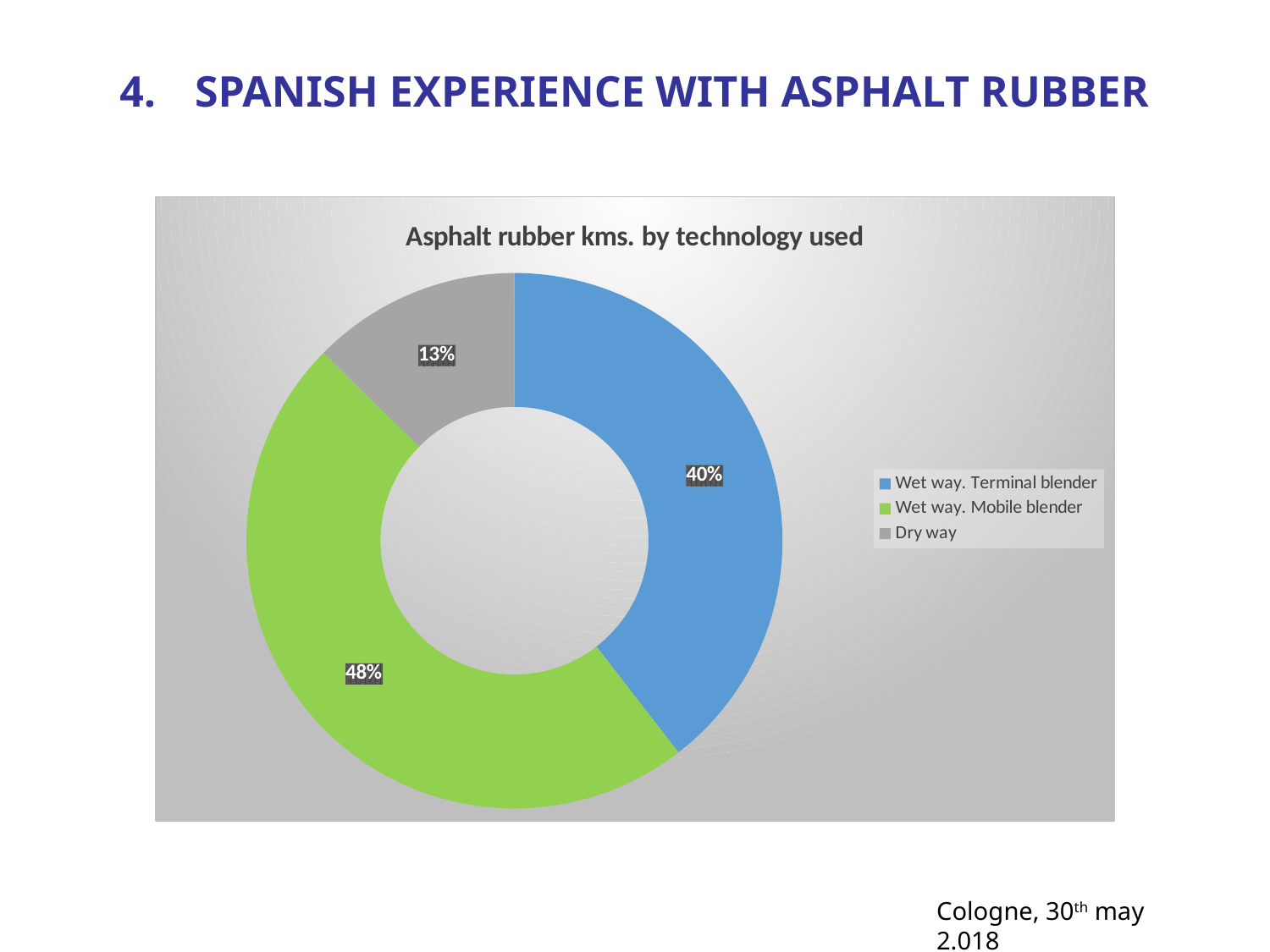
What is the title of the chart? Asphalt rubber kms. by technology used Which colour represents Dry way in the chart? Grey What is the difference in percentage points between the Wet way. Terminal blender share and the Dry way share? 27 Which technology has the largest share of asphalt rubber kms? Wet way. Mobile blender Which technology has the smallest share of asphalt rubber kms? Dry way Which has a larger share, Wet way. Terminal blender or Dry way? Wet way. Terminal blender What share of asphalt rubber kms is attributed to Wet way. Mobile blender? 48% What is the difference in percentage points between the Wet way. Mobile blender share and the Wet way. Terminal blender share? 8 What share of asphalt rubber kms is attributed to Dry way? 13% What kind of chart is shown on the slide? Doughnut chart How many categories does the chart show? 3 What share of asphalt rubber kms is attributed to Wet way. Terminal blender? 40%